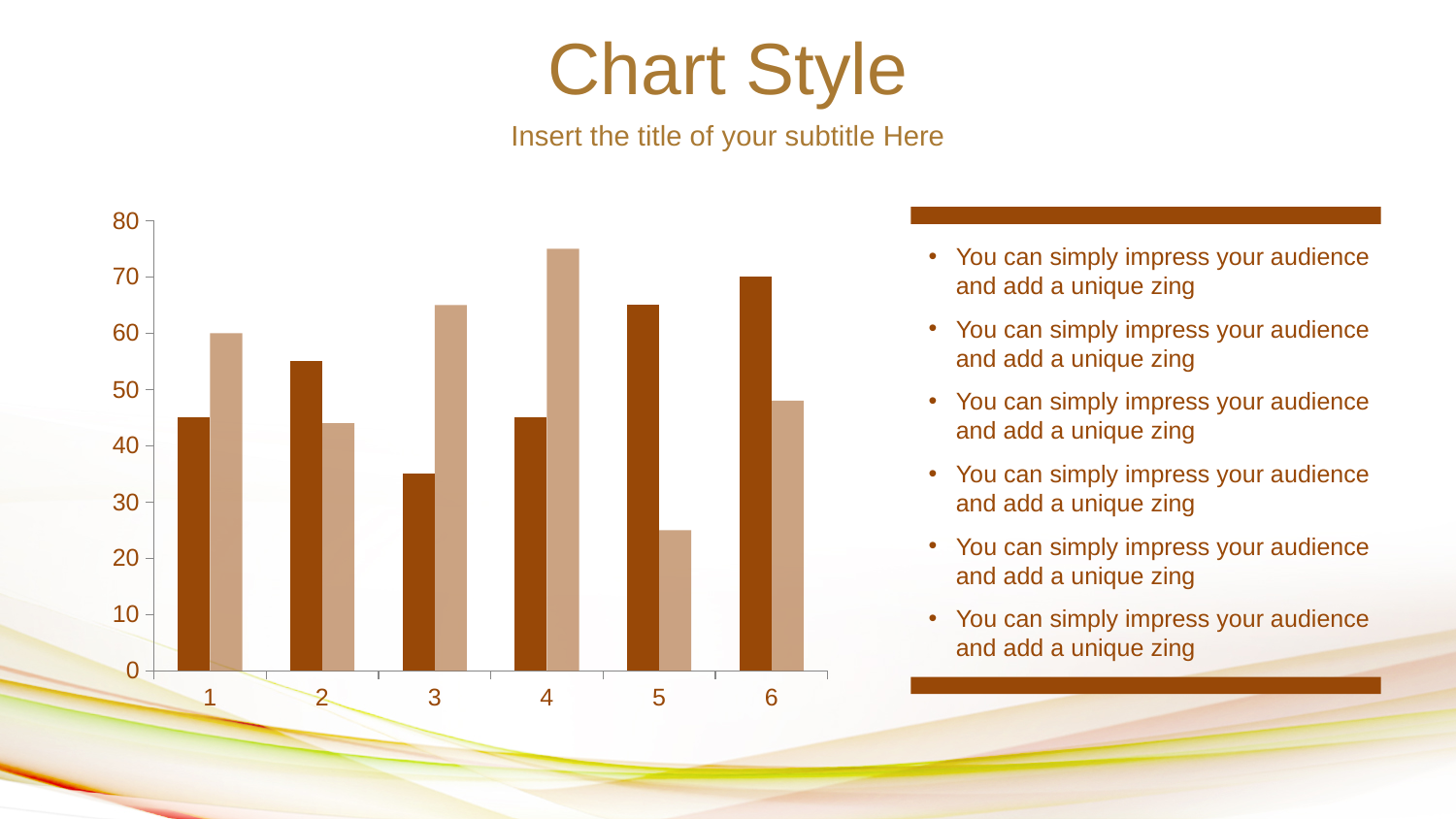
How many categories are shown on the x axis of the chart? 6 What is the value of the light tan bar for category 1? 60 What is the value of the dark brown bar for category 6? 70 What is the highest value shown on the vertical axis of the chart? 80 Which category has the shortest light tan bar? 5 What kind of chart is shown on the slide? bar chart For category 5, which bar is taller, the dark brown bar or the light tan bar? dark brown bar Which category has the tallest light tan bar? 4 Which category has the tallest dark brown bar? 6 Is the value of the dark brown bar for category 3 greater or less than 40? less Which category has the shortest dark brown bar? 3 Is the value of the light tan bar for category 4 greater or less than 70? greater